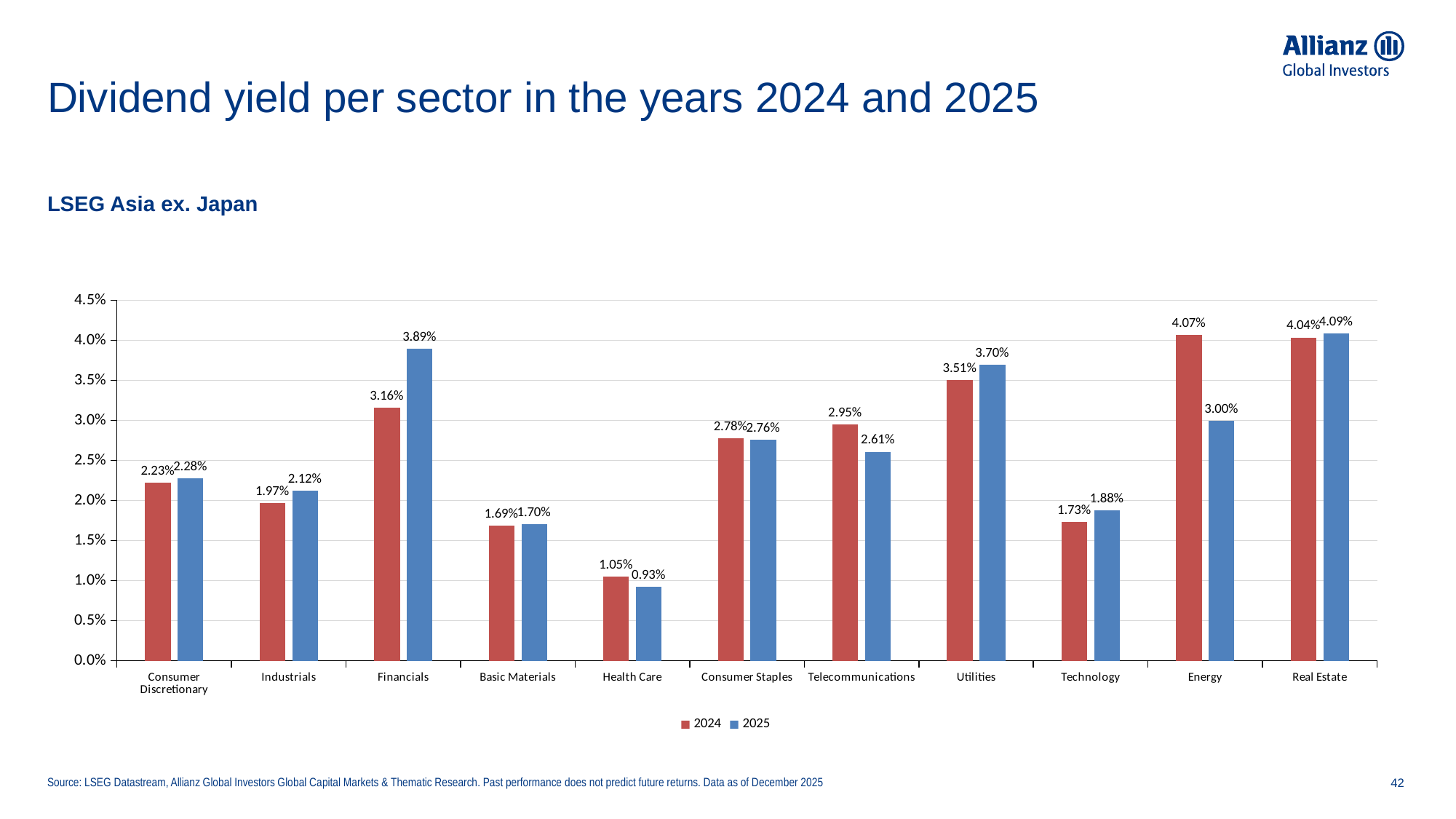
Which colour represents the 2025 series? Blue What is the 2025 dividend yield for Financials? 3.89% Which is larger for Telecommunications: the 2024 or the 2025 dividend yield? 2024 What is the difference between the 2024 and 2025 dividend yields for Energy? 1.07% How many sectors are shown on the x axis? 11 What is the 2024 dividend yield for Health Care? 1.05% What kind of chart is shown on the slide? Bar chart How many series does the legend list? 2 What is the 2025 dividend yield for Energy? 3.00% Which sector has the lowest 2024 dividend yield? Health Care Is the 2024 dividend yield for Utilities greater or less than 3.0%? greater Which sector has the highest 2025 dividend yield? Real Estate